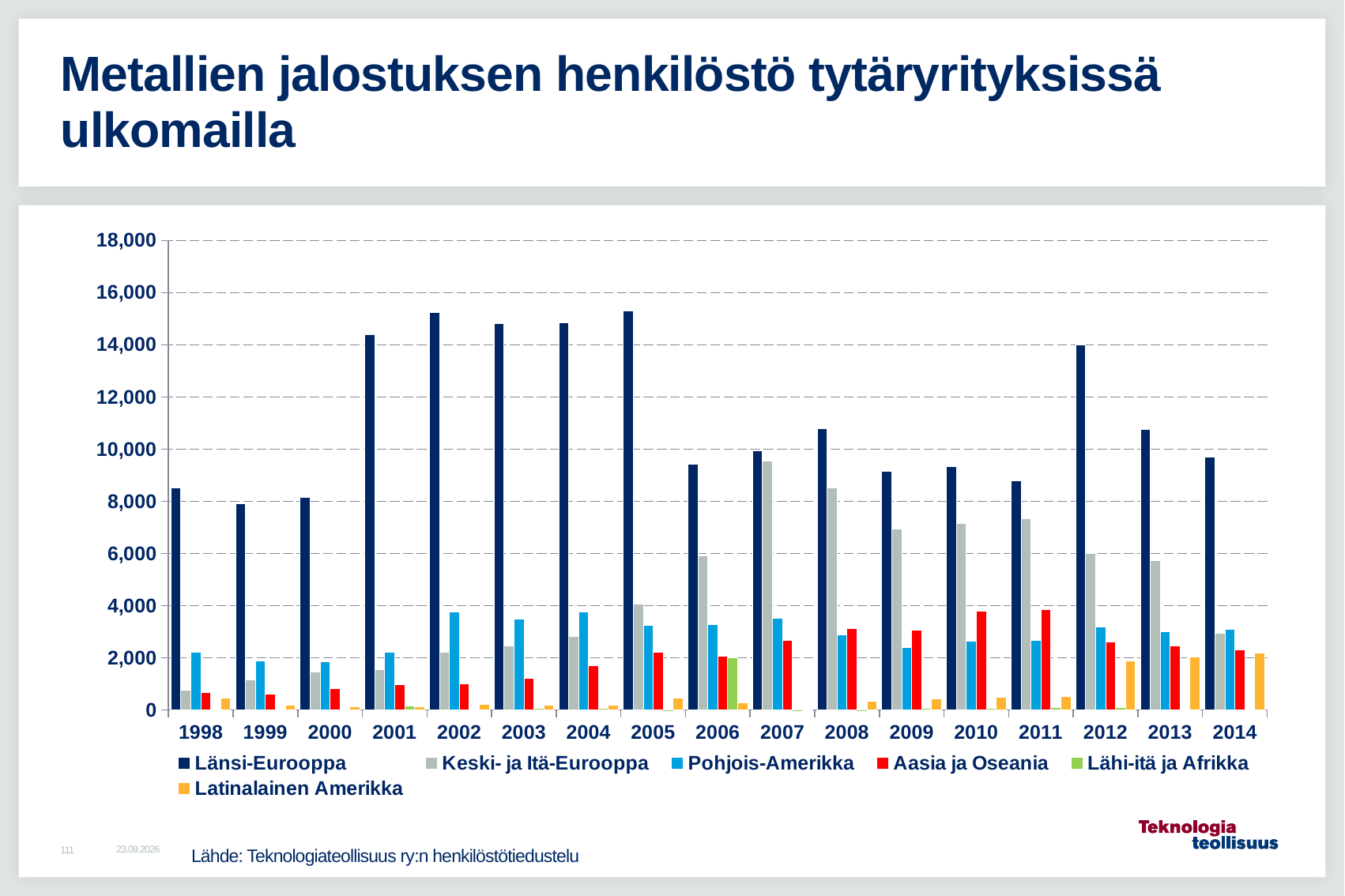
How many series does the legend list? 6 Which is larger for Länsi-Eurooppa: the value in 1998 or in 2001? 2001 Is the value for Länsi-Eurooppa in 2008 greater or less than 10,000? greater Is the value for Pohjois-Amerikka in 2005 greater or less than 2,000? greater How many years are shown on the x axis? 17 Does the value for Keski- ja Itä-Eurooppa rise or fall from 1998 to 2007? rise In which year is the value for Keski- ja Itä-Eurooppa highest? 2007 Is the value for Länsi-Eurooppa in 2002 greater or less than 14,000? greater In 2010, which is larger: Aasia ja Oseania or Pohjois-Amerikka? Aasia ja Oseania What kind of chart is shown on the slide? bar chart